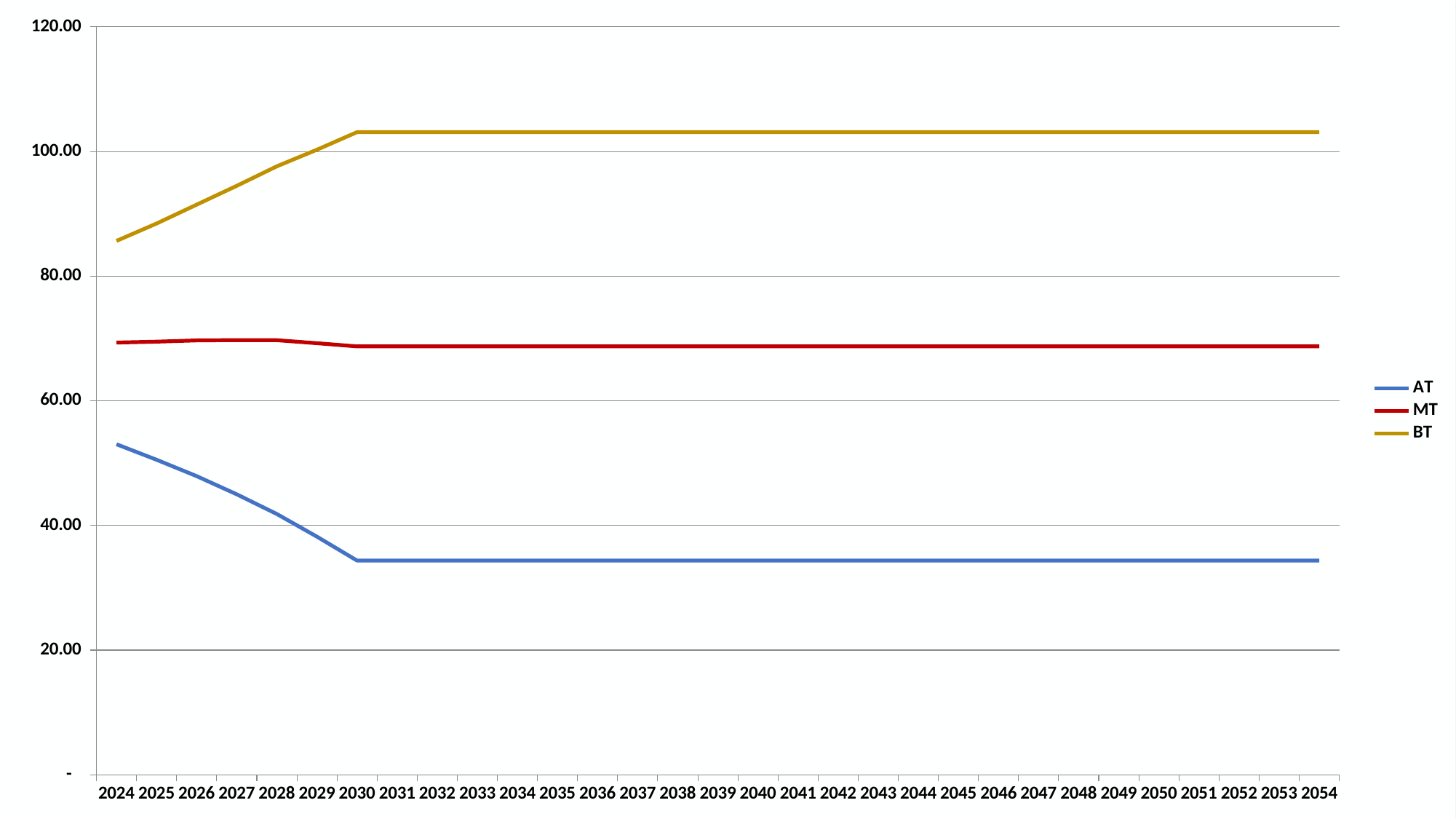
Which series are listed in the legend? AT, MT, BT How many series does the legend list? 3 Which series has the highest values across the chart? BT Does the BT series rise or fall between 2024 and 2030? rise How many years are shown along the x axis? 31 Is the value for AT in 2054 greater or less than 40.00? less Is the value for MT in 2024 greater or less than 60.00? greater Does the AT series rise or fall between 2024 and 2030? fall Which is larger in 2024, the value for MT or the value for AT? MT Which series has the lowest values across the chart? AT Is the value for BT in 2054 greater or less than 100.00? greater What kind of chart is shown on the slide? line chart